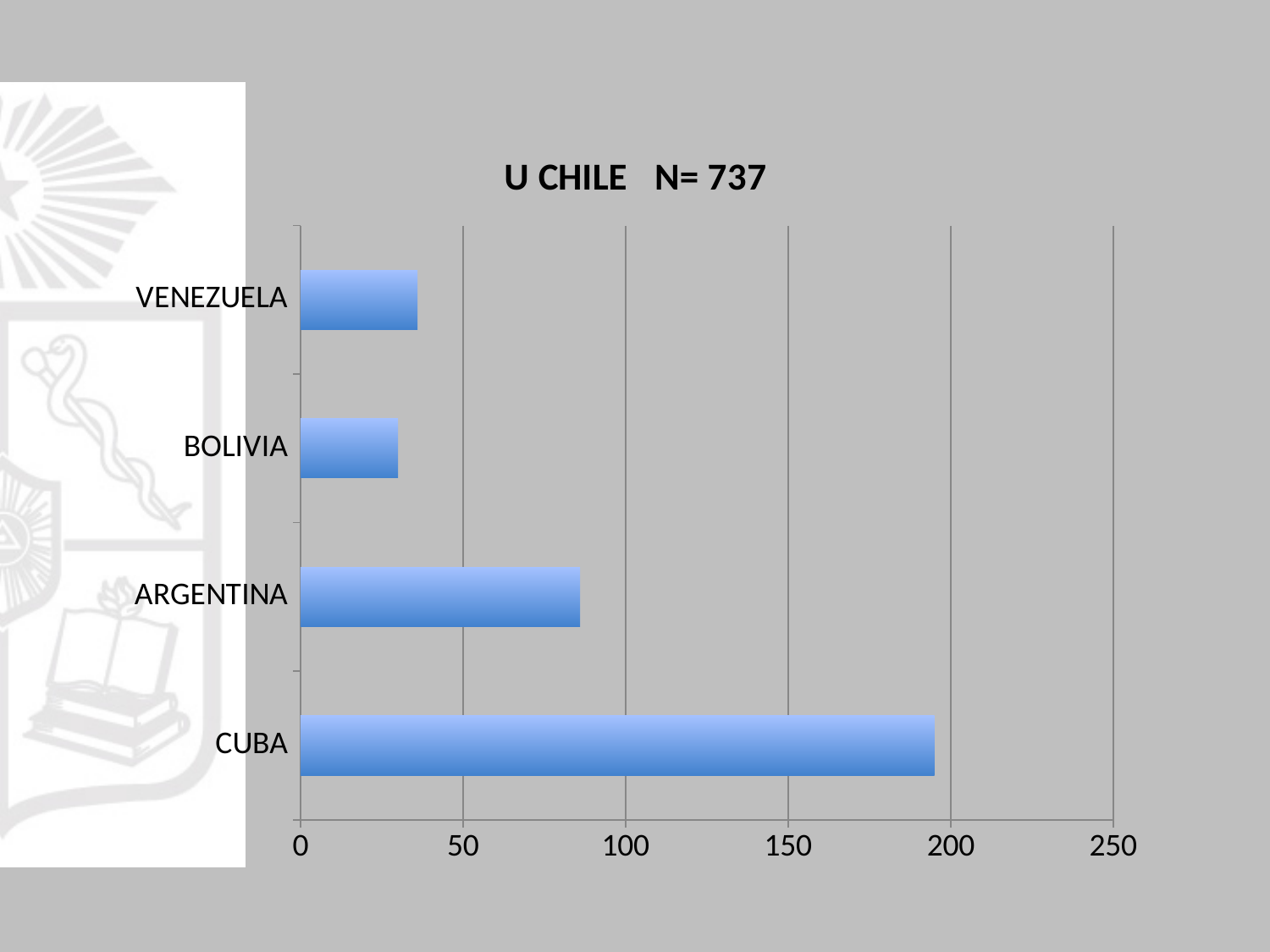
What kind of chart is shown on the slide? bar chart What is the title of the chart? U CHILE N= 737 Is the value for ARGENTINA greater or less than 50? greater How many countries are shown in the chart? 4 What is the highest value shown on the horizontal axis? 250 Is the value for ARGENTINA greater or less than 100? less Is the value for CUBA greater or less than 150? greater Which country has the lowest value in the chart? BOLIVIA Which country has the highest value in the chart? CUBA Which has a larger value, ARGENTINA or VENEZUELA? ARGENTINA